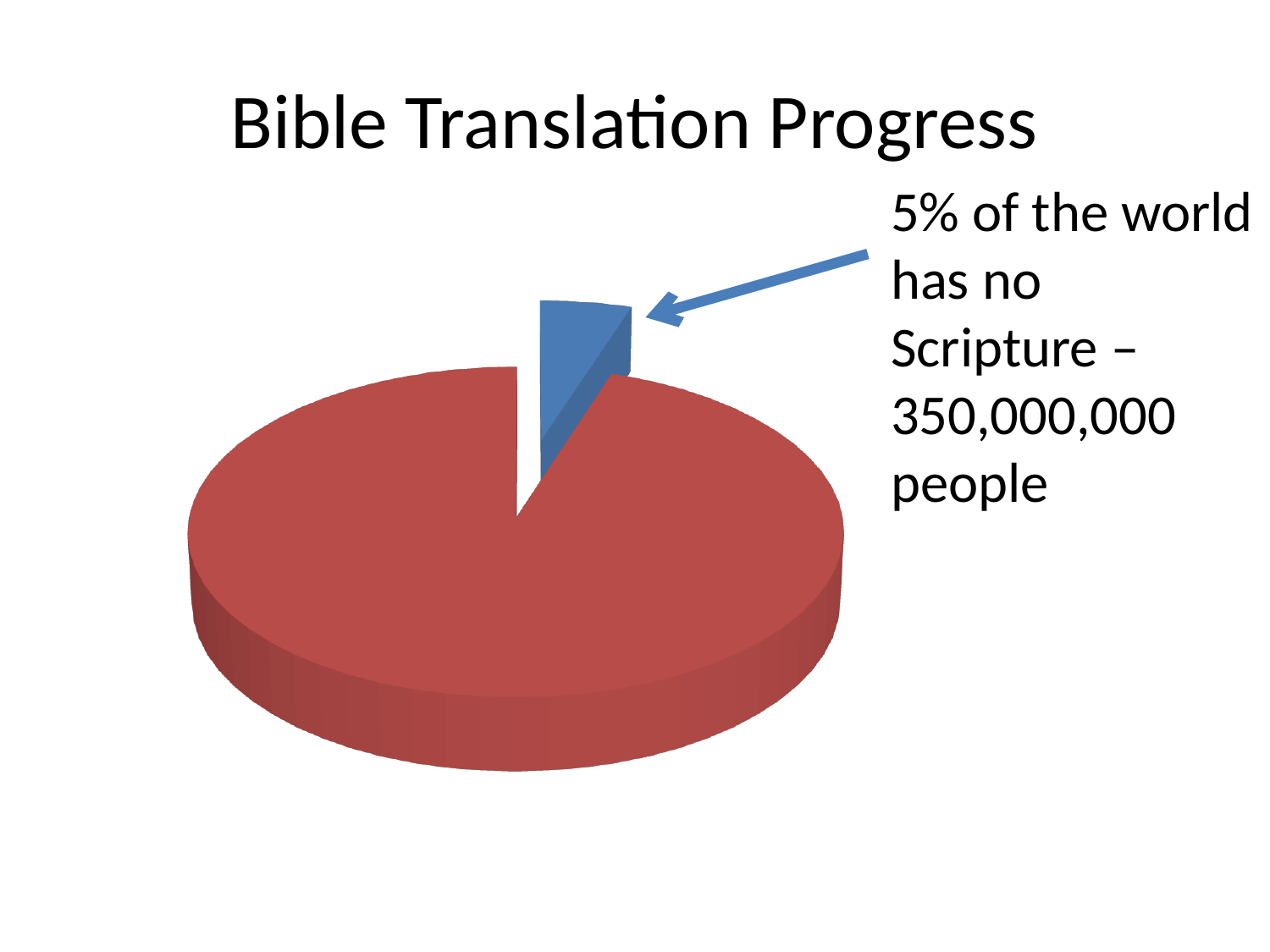
What colour is the slice that the arrow points to? Blue Which is larger, the red slice or the blue slice? The red slice Does the blue slice represent more or less than half of the pie? Less Which slice of the pie chart is the smallest? The blue slice What does the blue slice of the pie chart represent? The 5% of the world that has no Scripture What share of the pie does the blue slice represent? 5% What kind of chart is shown on the slide? Pie chart What share of the pie does the red slice represent? 95% How many slices does the pie chart have? 2 How many people does the blue slice of the pie chart represent? 350,000,000 people Which slice of the pie chart is the largest? The red slice What is the title of the chart? Bible Translation Progress